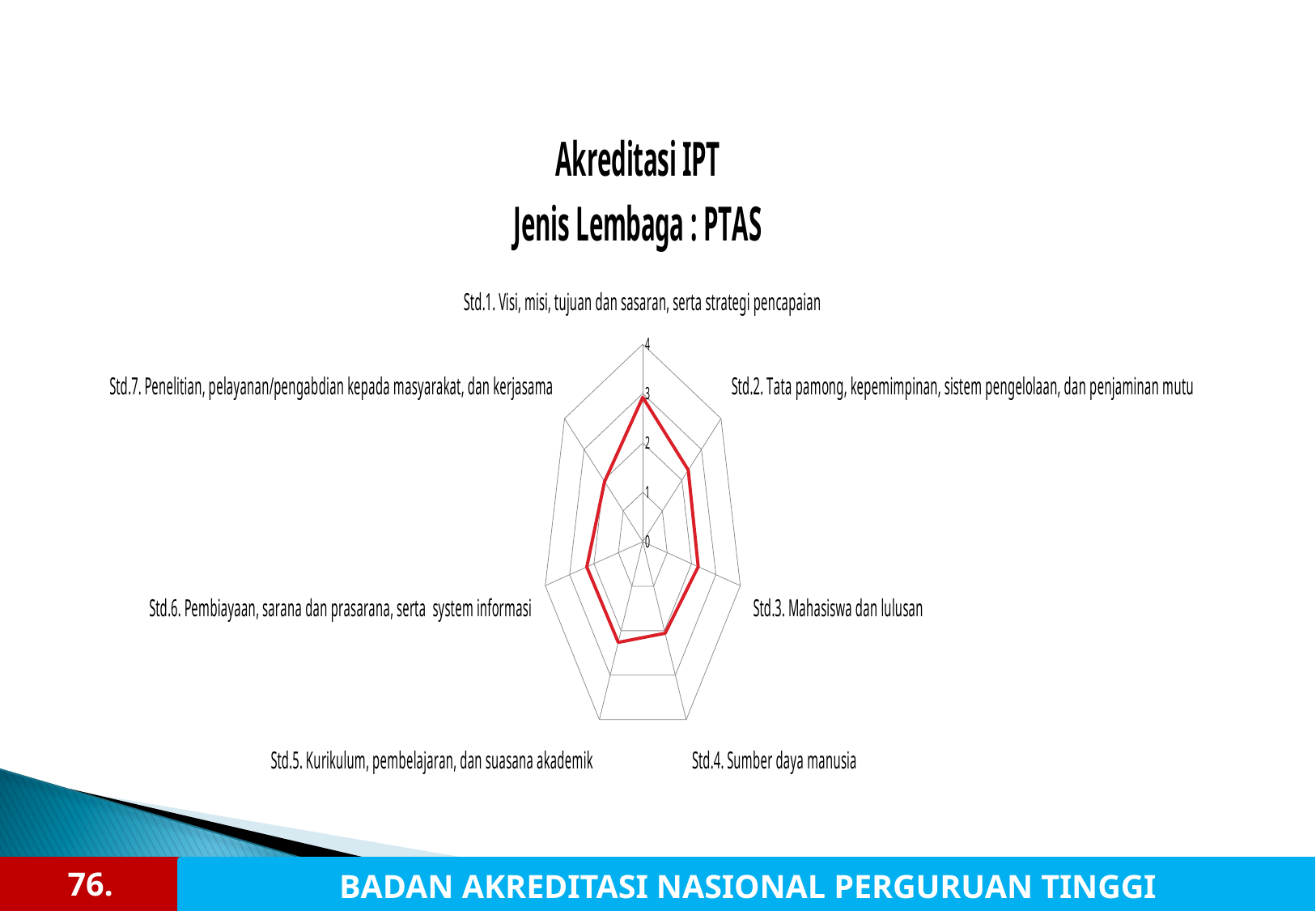
Is the value for Std.6. Pembiayaan, sarana dan prasarana, serta system informasi greater or less than 1? greater Which has the larger value: Std.1. Visi, misi, tujuan dan sasaran, serta strategi pencapaian or Std.3. Mahasiswa dan lulusan? Std.1. Visi, misi, tujuan dan sasaran, serta strategi pencapaian What is the title of the chart? Akreditasi IPT Jenis Lembaga : PTAS How many standards (categories) are plotted on the radar chart? 7 Is the value for Std.3. Mahasiswa dan lulusan greater or less than 3? less What kind of chart is shown on the slide? Radar chart Is the value for Std.4. Sumber daya manusia greater or less than 3? less What is the maximum value shown on the radar chart's axis scale? 4 Which standard has the highest value on the radar chart? Std.1. Visi, misi, tujuan dan sasaran, serta strategi pencapaian